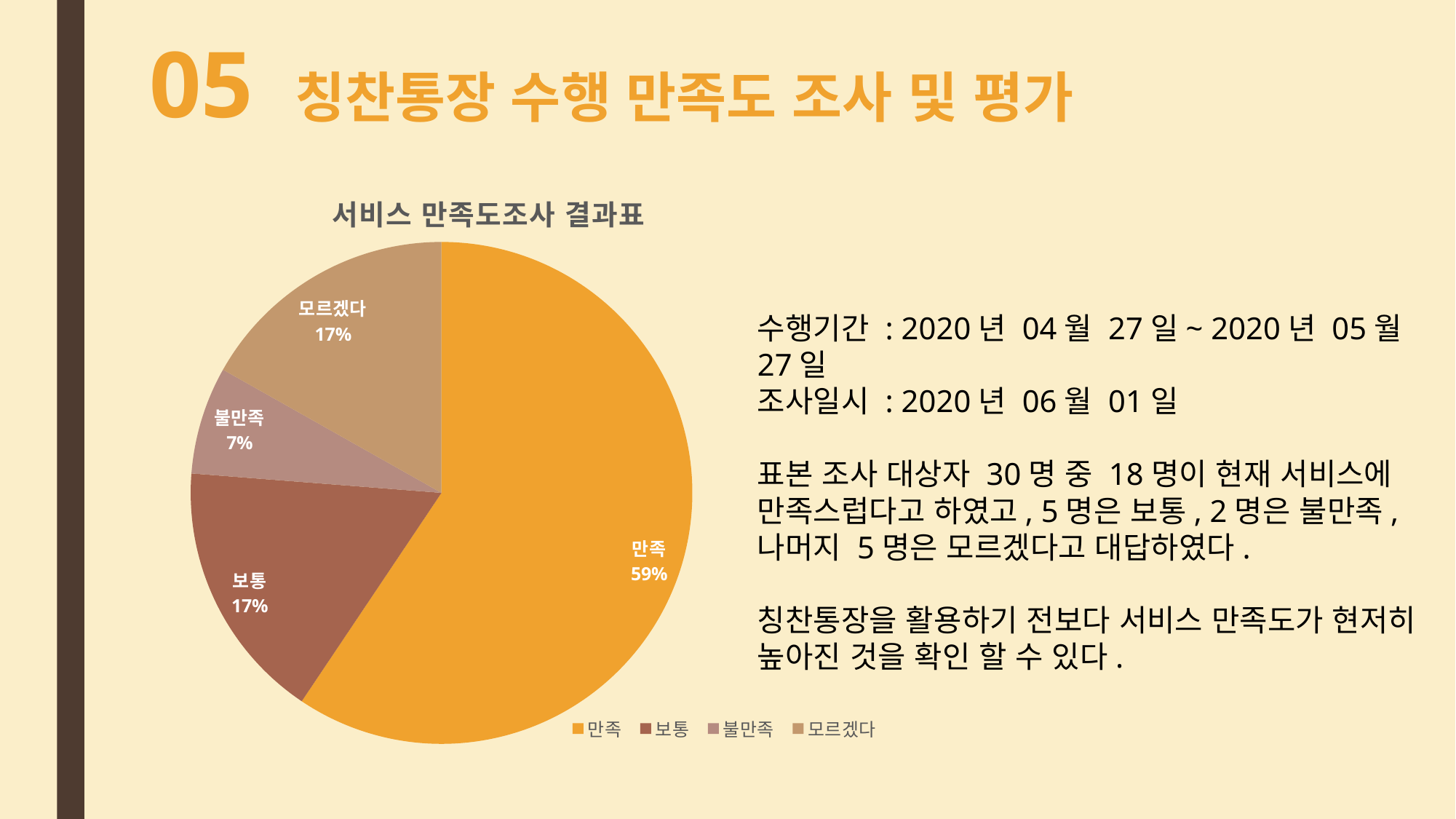
What is the title of the chart? 서비스 만족도조사 결과표 What is the value shown for 불만족? 7% How many categories are shown in the pie chart? 4 Which is larger, the share for 보통 or the share for 불만족? 보통 Which category has the largest slice of the pie? 만족 What is the difference between the 만족 share and the 보통 share? 42% What is the value shown for 모르겠다? 17% How many entries does the legend list? 4 What type of chart is shown on the slide? pie chart What share of the pie does 만족 take? 59% Which category has the smallest slice of the pie? 불만족 What is the value shown for 보통? 17%